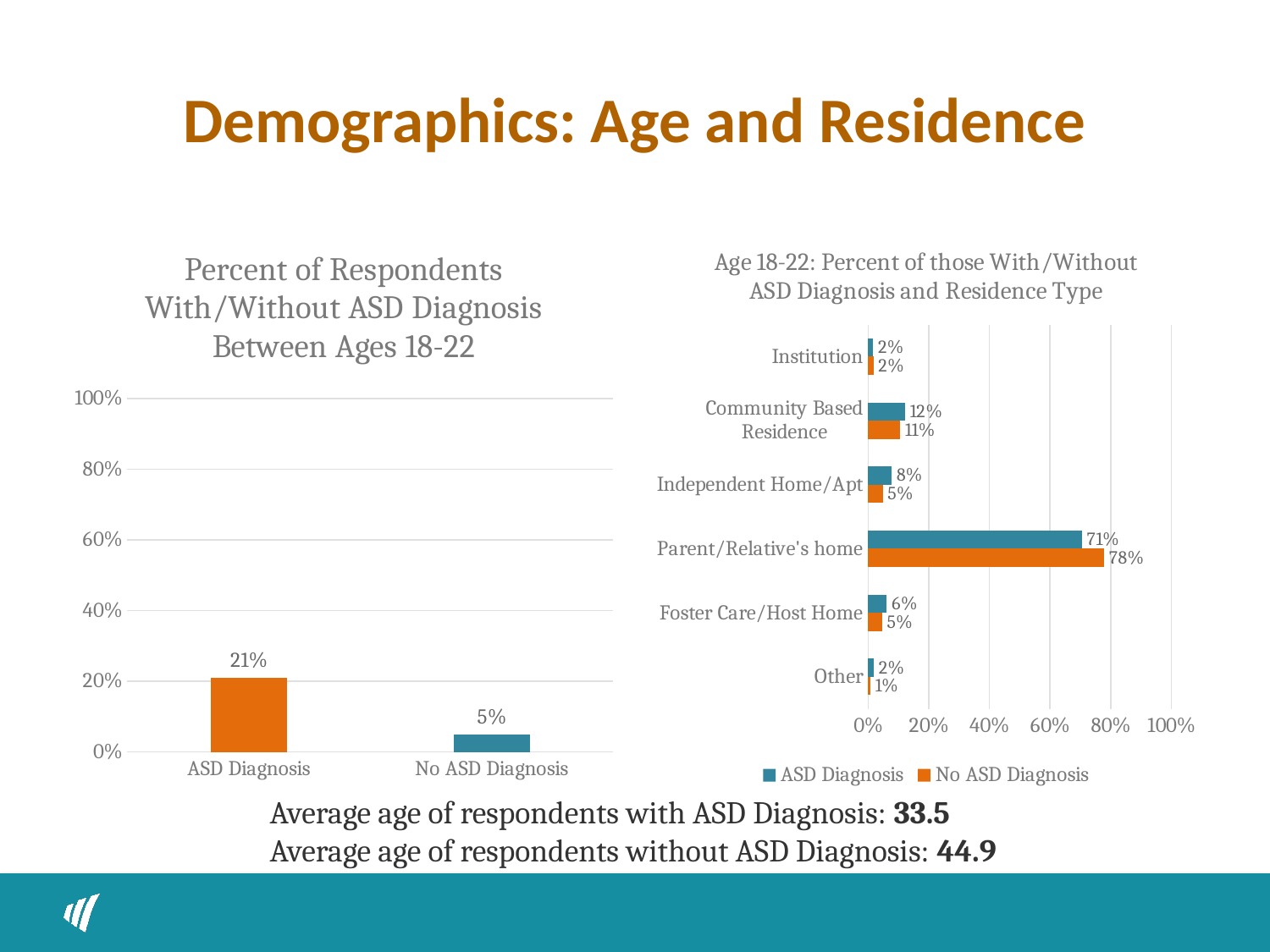
In the right chart 'Age 18-22: Percent of those With/Without ASD Diagnosis and Residence Type', how many series does the legend list? 2 In the right chart 'Age 18-22: Percent of those With/Without ASD Diagnosis and Residence Type', what is the No ASD Diagnosis value for Community Based Residence? 11% In the right chart 'Age 18-22: Percent of those With/Without ASD Diagnosis and Residence Type', what is the difference between the No ASD Diagnosis and ASD Diagnosis values for Parent/Relative's home? 7% In the left chart 'Percent of Respondents With/Without ASD Diagnosis Between Ages 18-22', what is the value for ASD Diagnosis? 21% In the left chart 'Percent of Respondents With/Without ASD Diagnosis Between Ages 18-22', what is the value for No ASD Diagnosis? 5% In the right chart 'Age 18-22: Percent of those With/Without ASD Diagnosis and Residence Type', which residence type has the lowest No ASD Diagnosis value? Other In the right chart 'Age 18-22: Percent of those With/Without ASD Diagnosis and Residence Type', which is larger for Independent Home/Apt: the ASD Diagnosis value or the No ASD Diagnosis value? ASD Diagnosis What kind of chart is the right chart 'Age 18-22: Percent of those With/Without ASD Diagnosis and Residence Type'? Bar chart In the left chart 'Percent of Respondents With/Without ASD Diagnosis Between Ages 18-22', what is the difference between the ASD Diagnosis and No ASD Diagnosis values? 16% In the right chart 'Age 18-22: Percent of those With/Without ASD Diagnosis and Residence Type', which residence type has the highest No ASD Diagnosis value? Parent/Relative's home In the right chart 'Age 18-22: Percent of those With/Without ASD Diagnosis and Residence Type', what is the ASD Diagnosis value for Parent/Relative's home? 71% In the left chart 'Percent of Respondents With/Without ASD Diagnosis Between Ages 18-22', how many categories are shown? 2